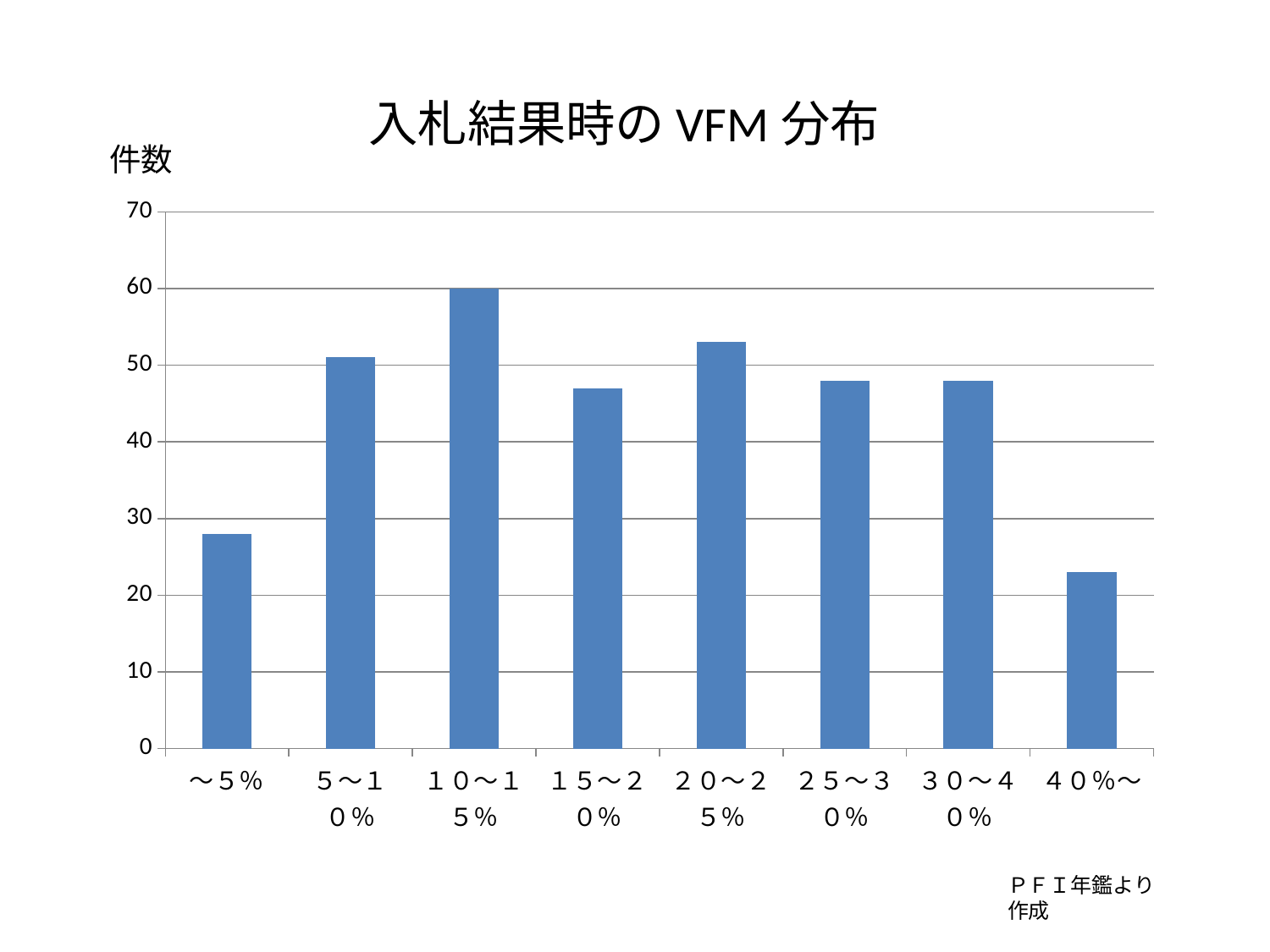
Is the value for 20～25% greater or less than 50? greater Which is larger, the value for 20～25% or the value for 15～20%? 20～25% Which category has the highest value in the chart? 10～15% Is the value for ～5% greater or less than 30? less Which category has the lowest value in the chart? 40%～ What is the label on the vertical axis of the chart? 件数 How many categories are shown on the x axis of the chart? 8 What kind of chart is shown on the slide? bar chart Which is larger, the value for ～5% or the value for 5～10%? 5～10% What is the value for the 10～15% category? 60 Is the value for 40%～ greater or less than 20? greater What is the title of the chart? 入札結果時のVFM分布